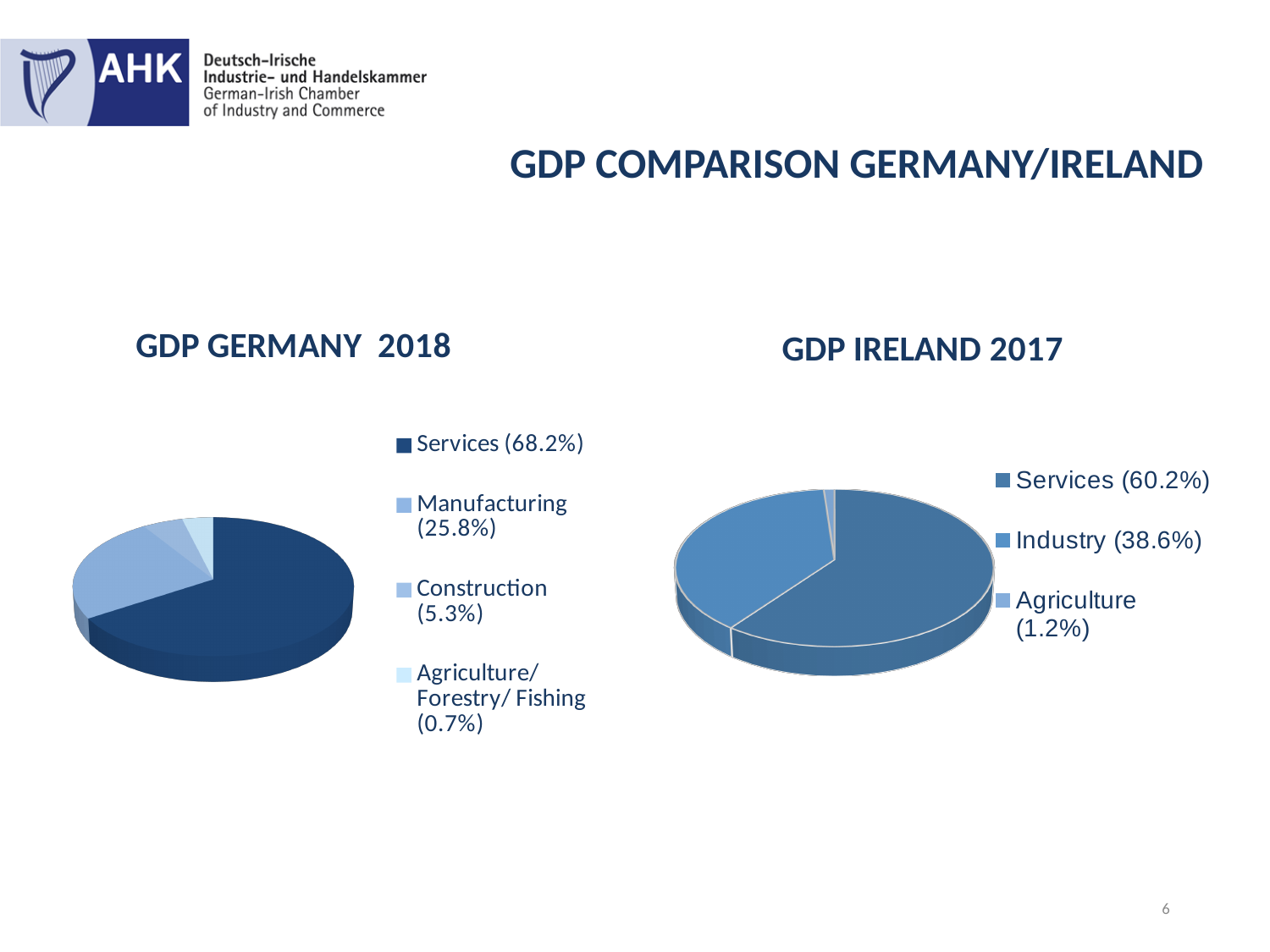
In the GDP Ireland 2017 chart, which category has the largest share? Services In the GDP Ireland 2017 chart, what share does Industry have? 38.6% In the GDP Germany 2018 chart, what share does Construction have? 5.3% In the GDP Germany 2018 chart, what share does Services have? 68.2% In the GDP Germany 2018 chart, what share does Manufacturing have? 25.8% In the GDP Germany 2018 chart, which category has the smallest share? Agriculture/ Forestry/ Fishing In the GDP Ireland 2017 chart, what share does Agriculture have? 1.2% How many categories does the GDP Germany 2018 chart show? 4 In the GDP Ireland 2017 chart, what is the difference between the Services share and the Industry share? 21.6% What kind of chart is the GDP Ireland 2017 chart? Pie chart In the GDP Germany 2018 chart, what is the difference between the Services share and the Manufacturing share? 42.4% Which is larger: the Services share in the GDP Germany 2018 chart or the Services share in the GDP Ireland 2017 chart? GDP Germany 2018